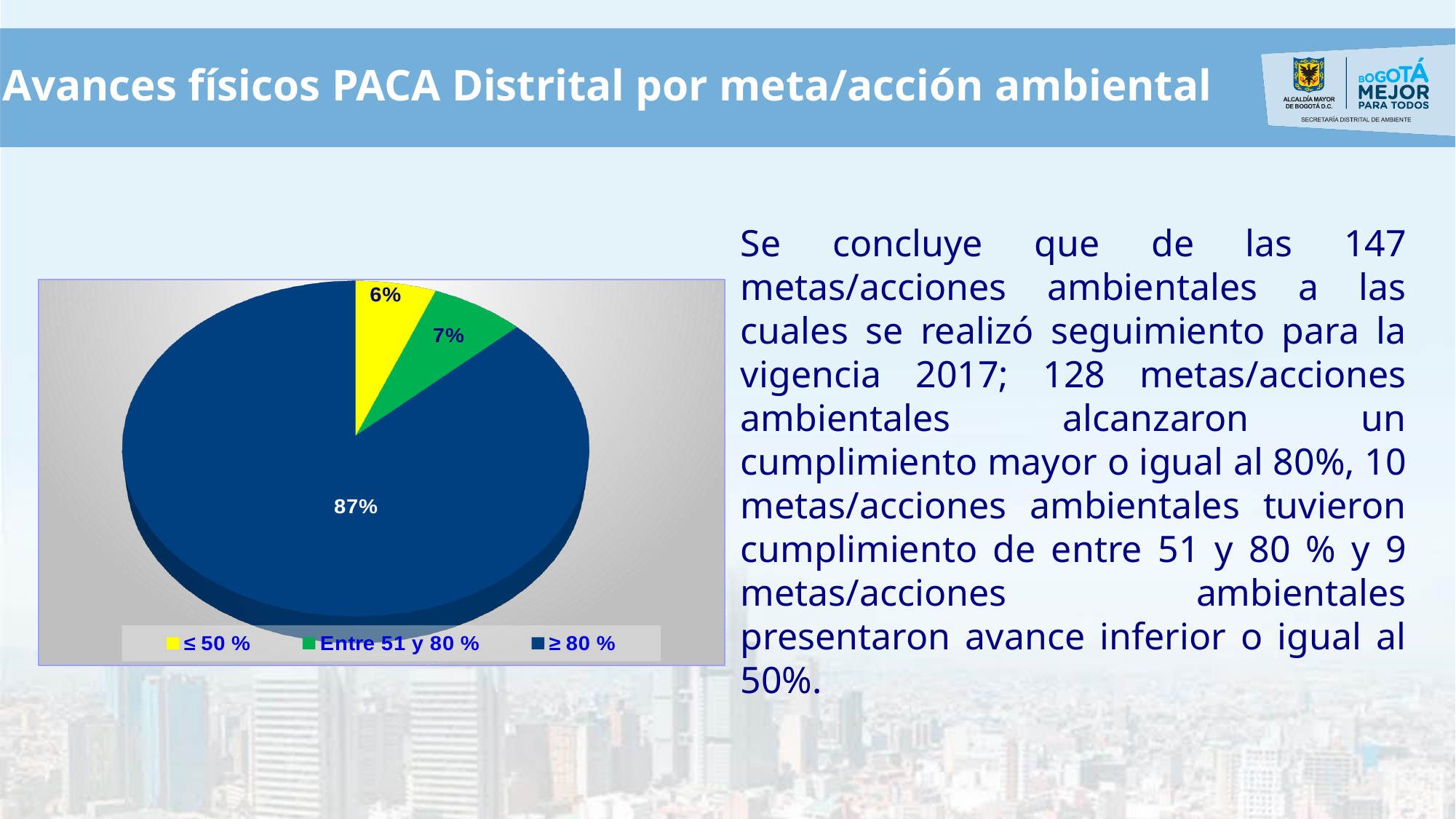
Which category has the smallest slice of the pie? ≤ 50 % What colour is the "≤ 50 %" slice in the pie chart? Yellow Which slice is larger: "Entre 51 y 80 %" or "≤ 50 %"? Entre 51 y 80 % What colour is the "≥ 80 %" slice in the pie chart? Dark blue What share of the pie does the "≤ 50 %" slice represent? 6% What is the combined share of the "≤ 50 %" and "Entre 51 y 80 %" slices? 13% What share of the pie does the "Entre 51 y 80 %" slice represent? 7% Which category has the largest slice of the pie? ≥ 80 % What is the difference in percentage points between the "≥ 80 %" slice and the "Entre 51 y 80 %" slice? 80 What share of the pie does the "≥ 80 %" slice represent? 87% What kind of chart is shown on the slide? Pie chart How many slices does the pie chart have? 3